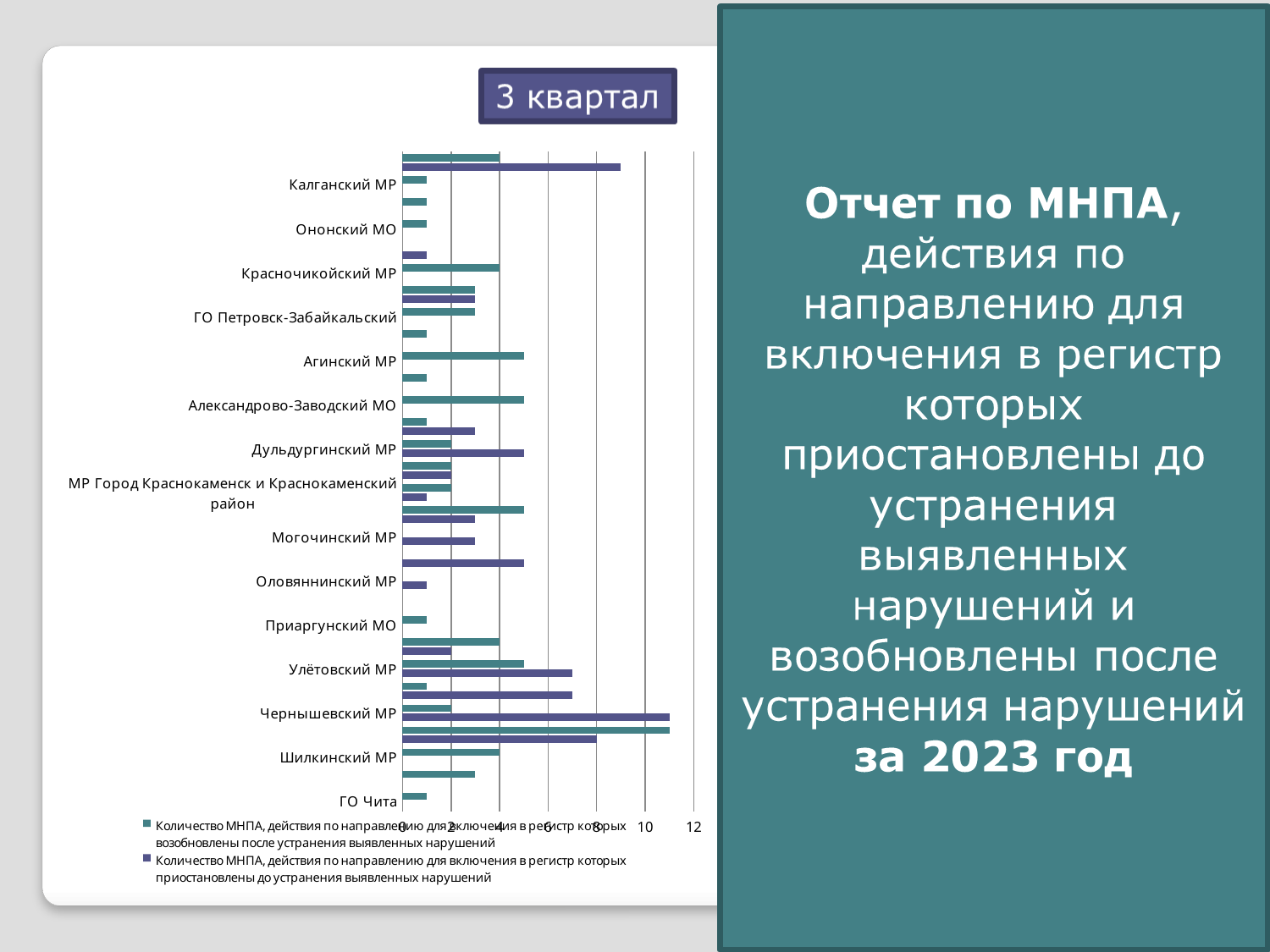
Is the value for Александрово-Заводский МО in the series 'возобновлены после устранения выявленных нарушений' greater or less than 4? greater In the series 'возобновлены после устранения выявленных нарушений', which has the larger value: Агинский МР or Калганский МР? Агинский МР Is the value for Калганский МР in the series 'возобновлены после устранения выявленных нарушений' greater or less than 2? less What is the highest value labelled on the x axis of the chart? 12 Is the value for Красночикойский МР in the series 'возобновлены после устранения выявленных нарушений' greater or less than 2? greater What is the title shown above the chart? 3 квартал How many series does the chart legend list? 2 What kind of chart is shown on the slide? Bar chart